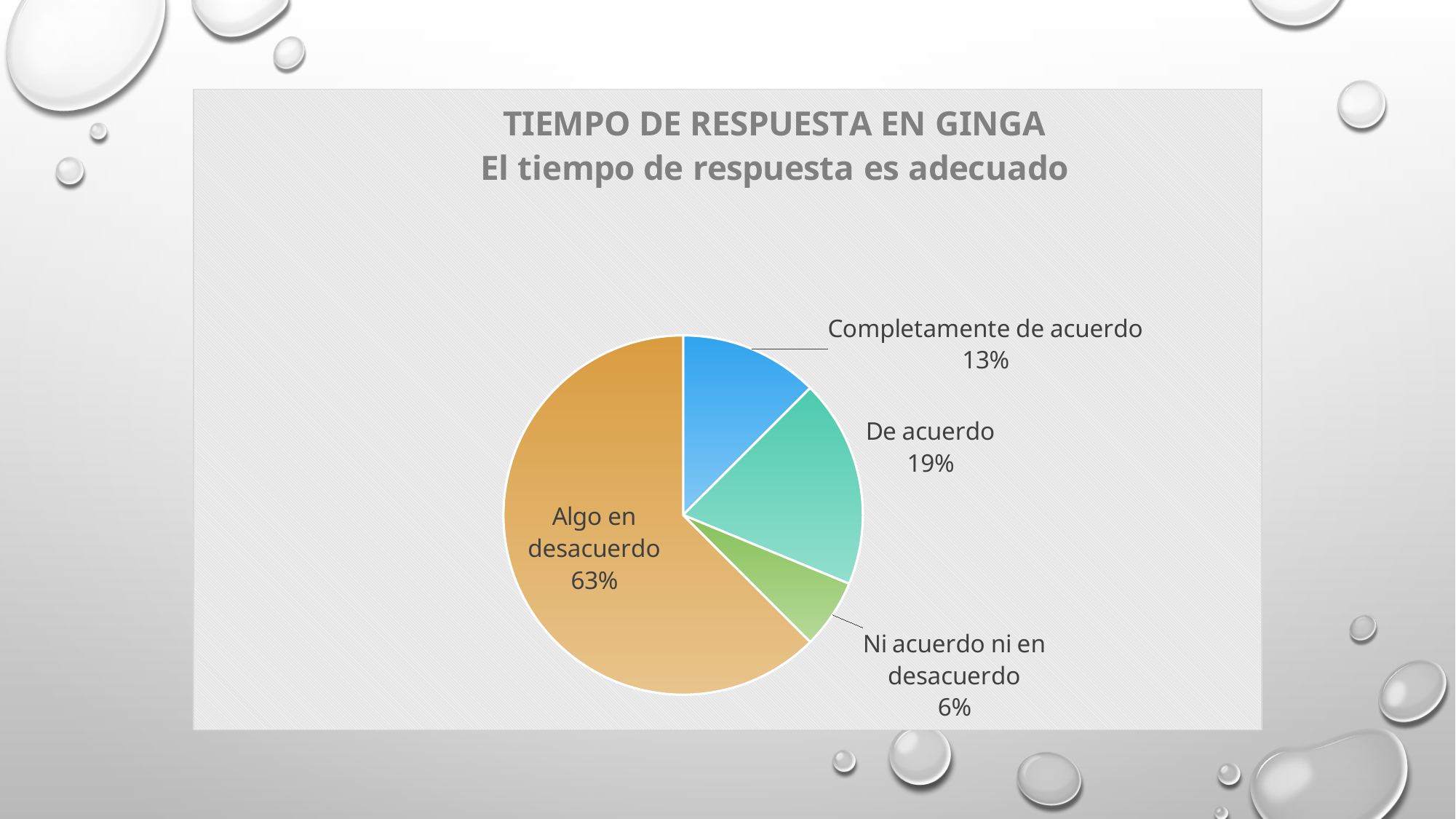
What share of the pie is labelled "Ni acuerdo ni en desacuerdo"? 6% What share of the pie is labelled "De acuerdo"? 19% What share of the pie is labelled "Algo en desacuerdo"? 63% What is the title of the chart? TIEMPO DE RESPUESTA EN GINGA El tiempo de respuesta es adecuado What share of the pie is labelled "Completamente de acuerdo"? 13% Which category has the smallest slice of the pie? Ni acuerdo ni en desacuerdo How many slices does the pie chart have? 4 What kind of chart is shown on the slide? pie chart What is the combined share of "Completamente de acuerdo" and "De acuerdo"? 32% Which is larger, the slice for "De acuerdo" or the slice for "Completamente de acuerdo"? De acuerdo What is the difference in percentage points between "Algo en desacuerdo" and "De acuerdo"? 44 Which category has the largest slice of the pie? Algo en desacuerdo